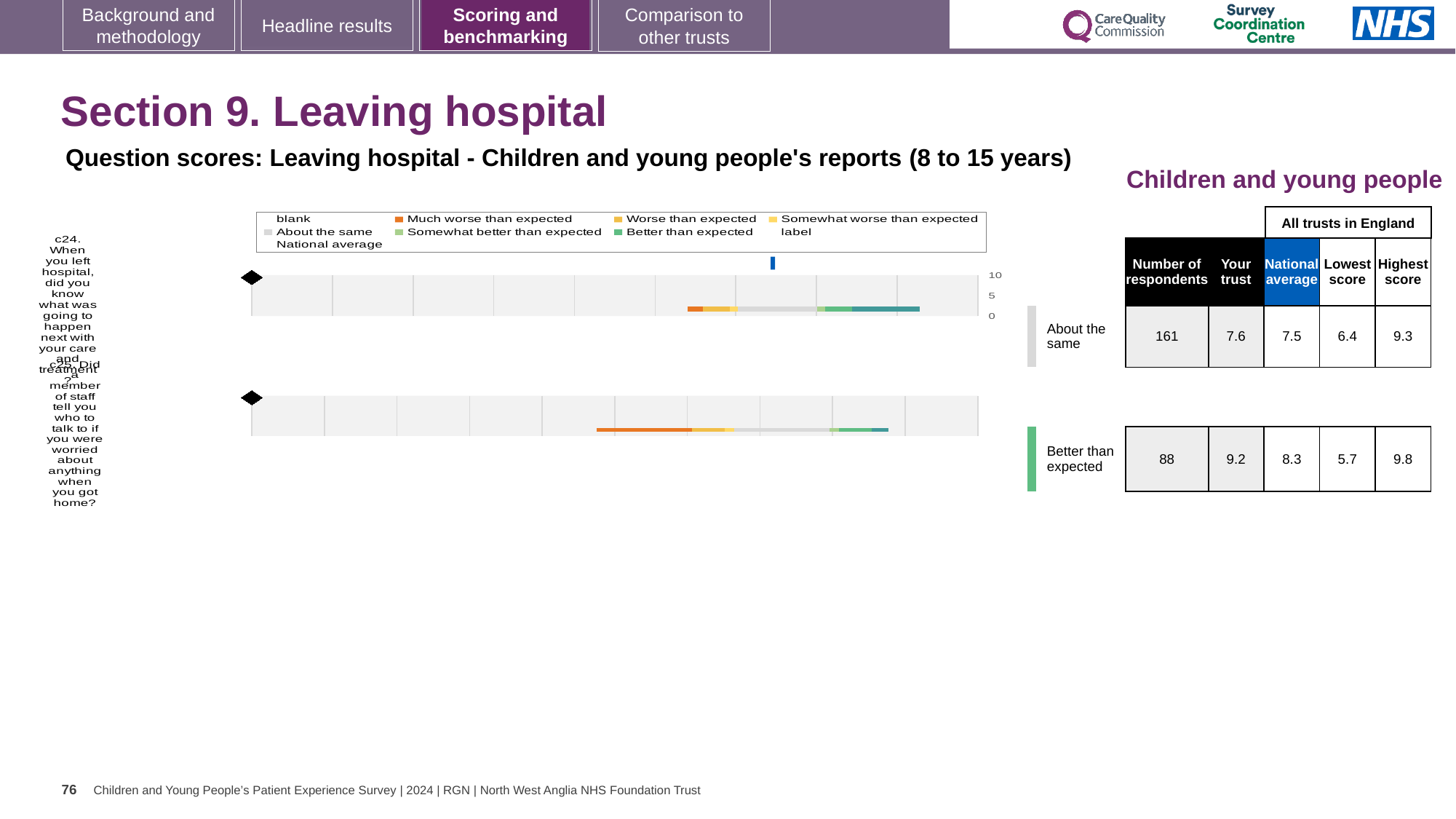
What is the national average score for question c24? 7.5 How many survey questions are plotted as bars in the chart? 2 What is the highest score across all trusts in England for question c25? 9.8 What is the 'Your trust' score for question c24 (When you left hospital, did you know what was going to happen next with your care and treatment?)? 7.6 Which benchmark category is question c25 placed in? Better than expected What is the difference between the trust's score and the national average for question c25? 0.9 What kind of chart is used to show the question scores for c24 and c25? bar chart How many respondents answered question c25? 88 What is the 'Your trust' score for question c25 (Did a member of staff tell you who to talk to if you were worried about anything when you got home?)? 9.2 Which question has the higher 'Your trust' score, c24 or c25? c25 Which legend entry is shown in orange? Much worse than expected How many entries does the chart legend list? 9